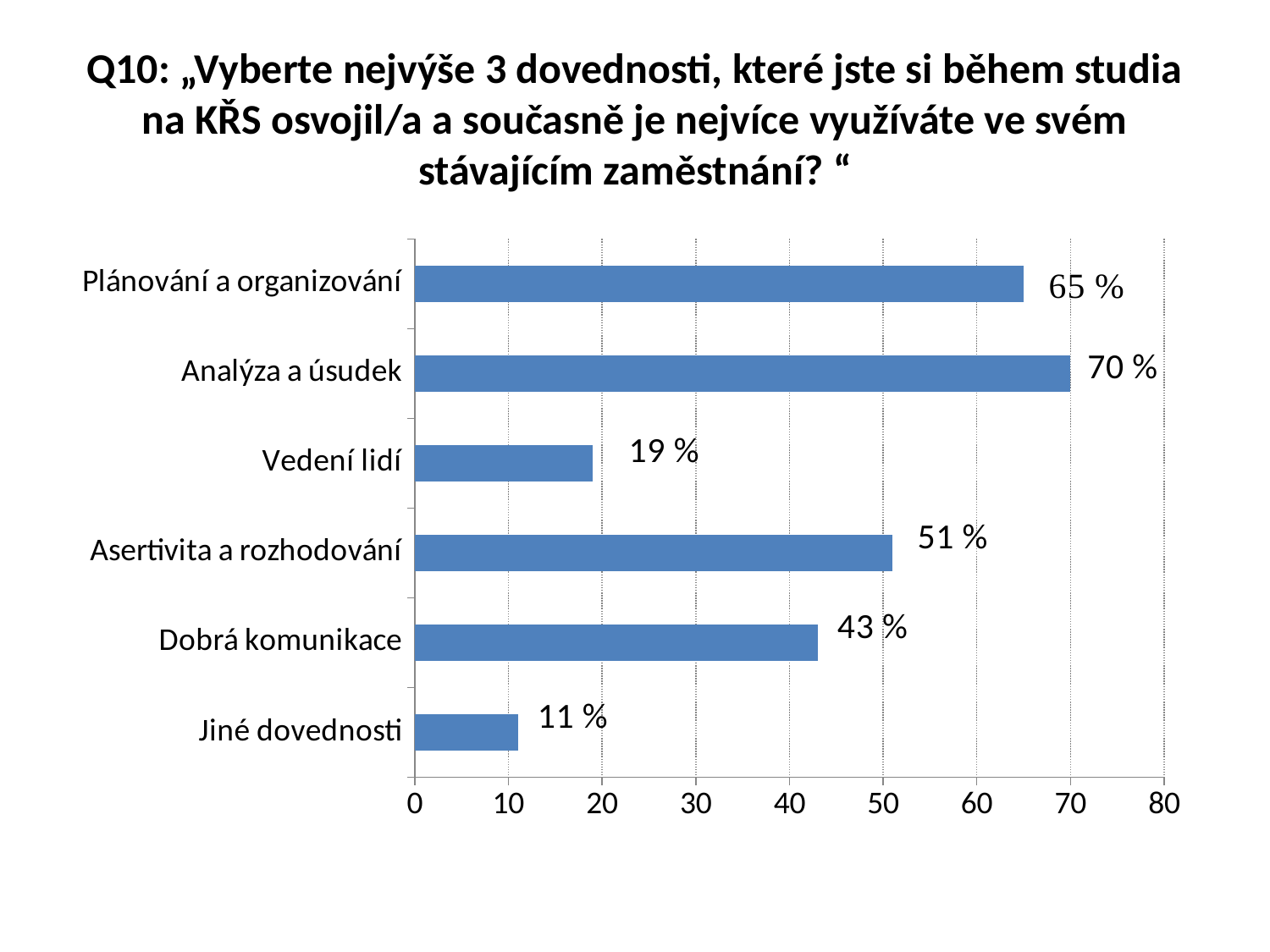
What is the difference between the values for Analýza a úsudek and Plánování a organizování? 5 % What kind of chart is shown on the slide? bar chart What is the value for Vedení lidí? 19 % What is the difference between the values for Asertivita a rozhodování and Dobrá komunikace? 8 % What is the value for Dobrá komunikace? 43 % How many categories are shown in the chart? 6 What is the maximum value shown on the horizontal axis? 80 Is the value for Plánování a organizování greater or less than 60? greater What is the value for Analýza a úsudek? 70 % Which category has the lowest value? Jiné dovednosti Which category has the highest value? Analýza a úsudek Which is larger, the value for Asertivita a rozhodování or the value for Vedení lidí? Asertivita a rozhodování